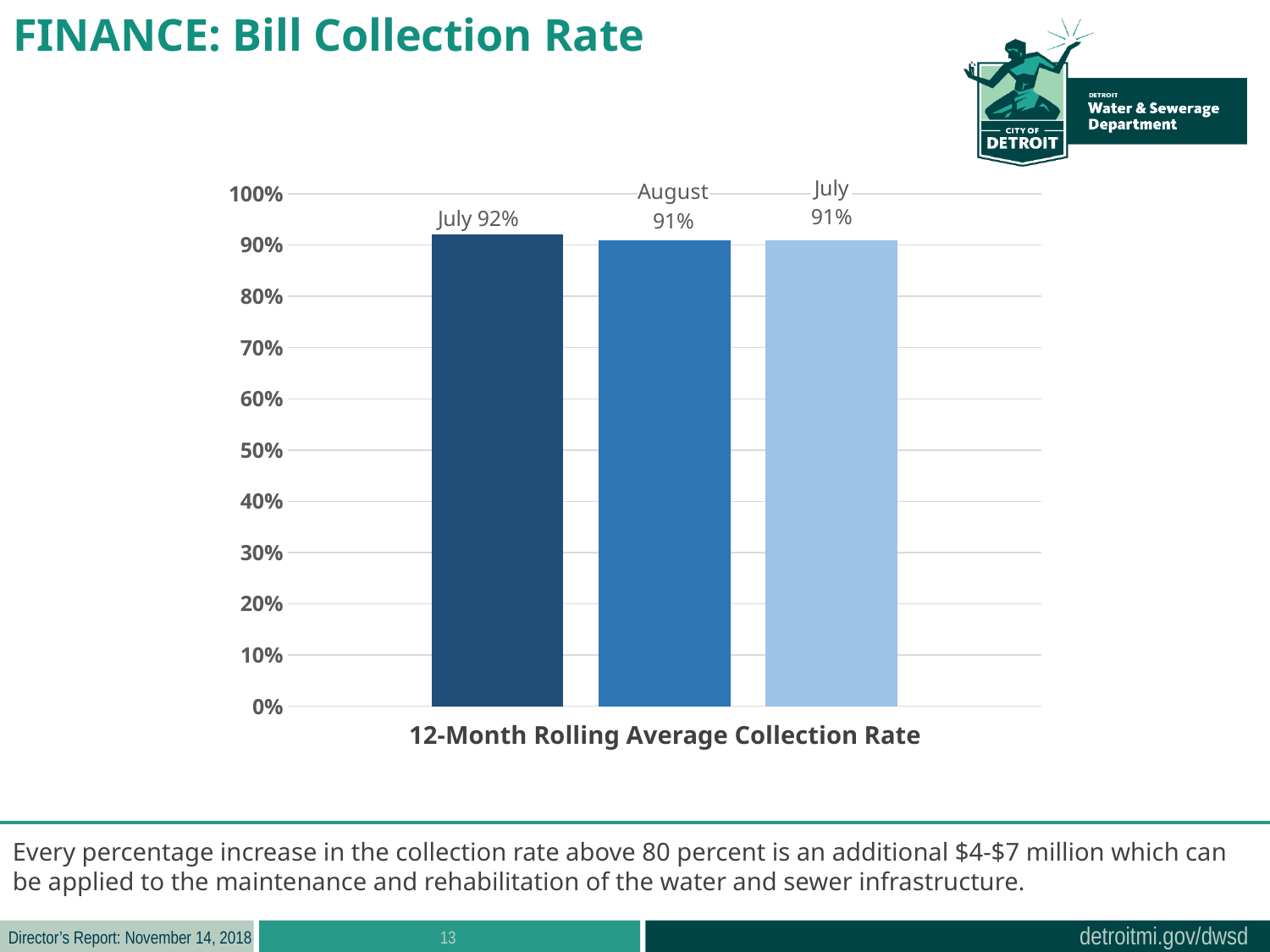
Is the value for August greater or less than 80%? greater What is the value shown on the rightmost bar of the chart? 91% What kind of chart is shown on the slide? Bar chart What is the value shown for the August bar? 91% Which bar has the highest value? The leftmost bar (July 92%) What is the value shown on the leftmost bar of the chart? 92% Which is larger, the value of the leftmost bar or the value of the August bar? The leftmost bar Does the value fall or rise from the leftmost bar to the middle (August) bar? Fall How many bars are plotted in the chart? 3 What is the label printed below the bars on the x axis? 12-Month Rolling Average Collection Rate What is the title of the slide? FINANCE: Bill Collection Rate What is the difference between the leftmost bar's value and the August bar's value? 1%